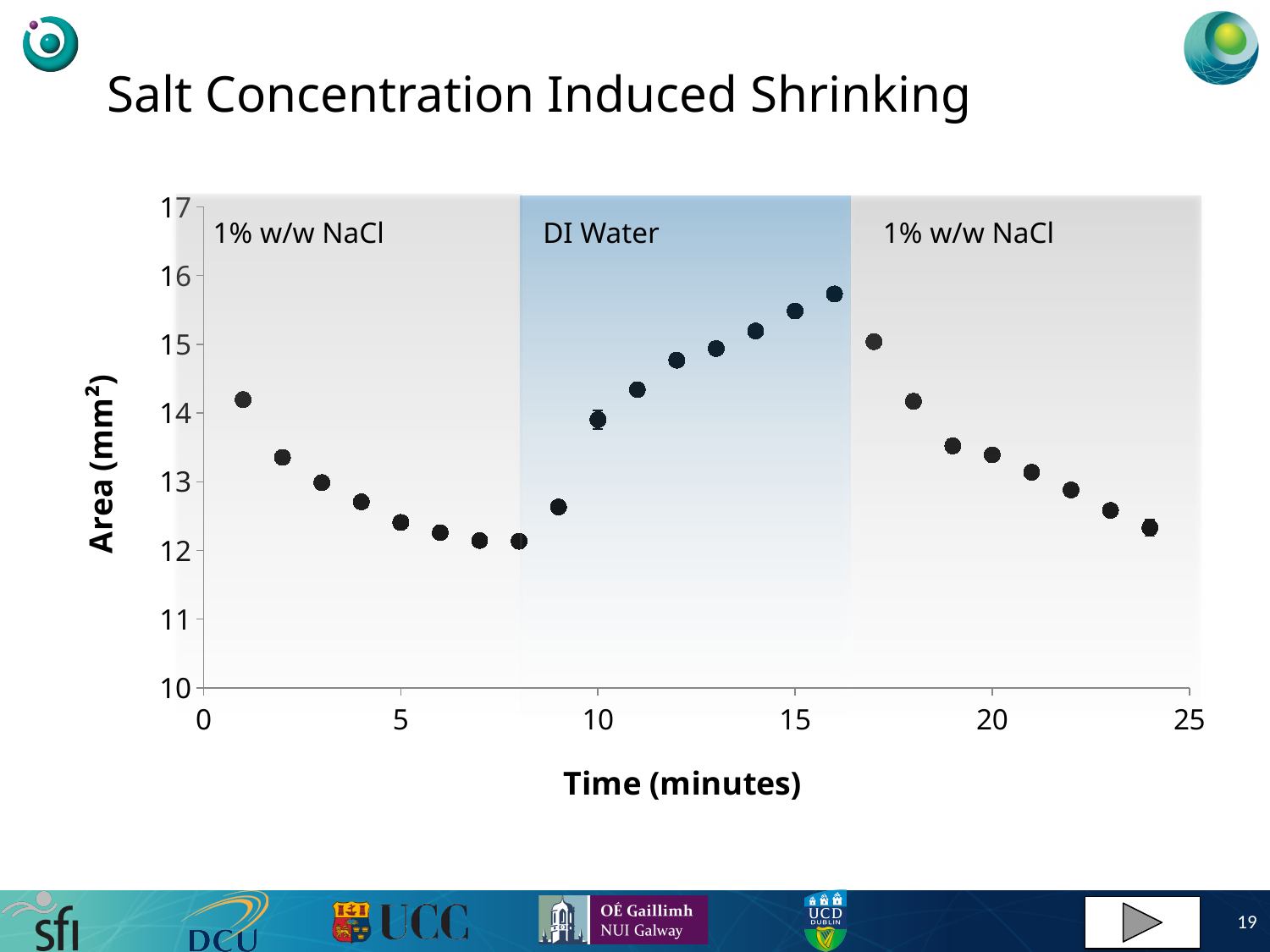
Is the area at 16 minutes greater or less than 15 mm²? greater Is the area at 8 minutes greater or less than 13 mm²? less Is the area at 24 minutes greater or less than 13 mm²? less At which time (in minutes) is the area highest? 16 Do the area values rise or fall over time during the first 1% w/w NaCl period? fall Do the area values rise or fall over time during the DI Water period? rise What is the label of the y axis? Area (mm²) Which has the larger area: the point at 17 minutes or the point at 24 minutes? 17 minutes How many data points are plotted on the chart? 24 What kind of chart is shown on the slide? scatter chart Which has the larger area: the point at 16 minutes or the point at 1 minute? 16 minutes